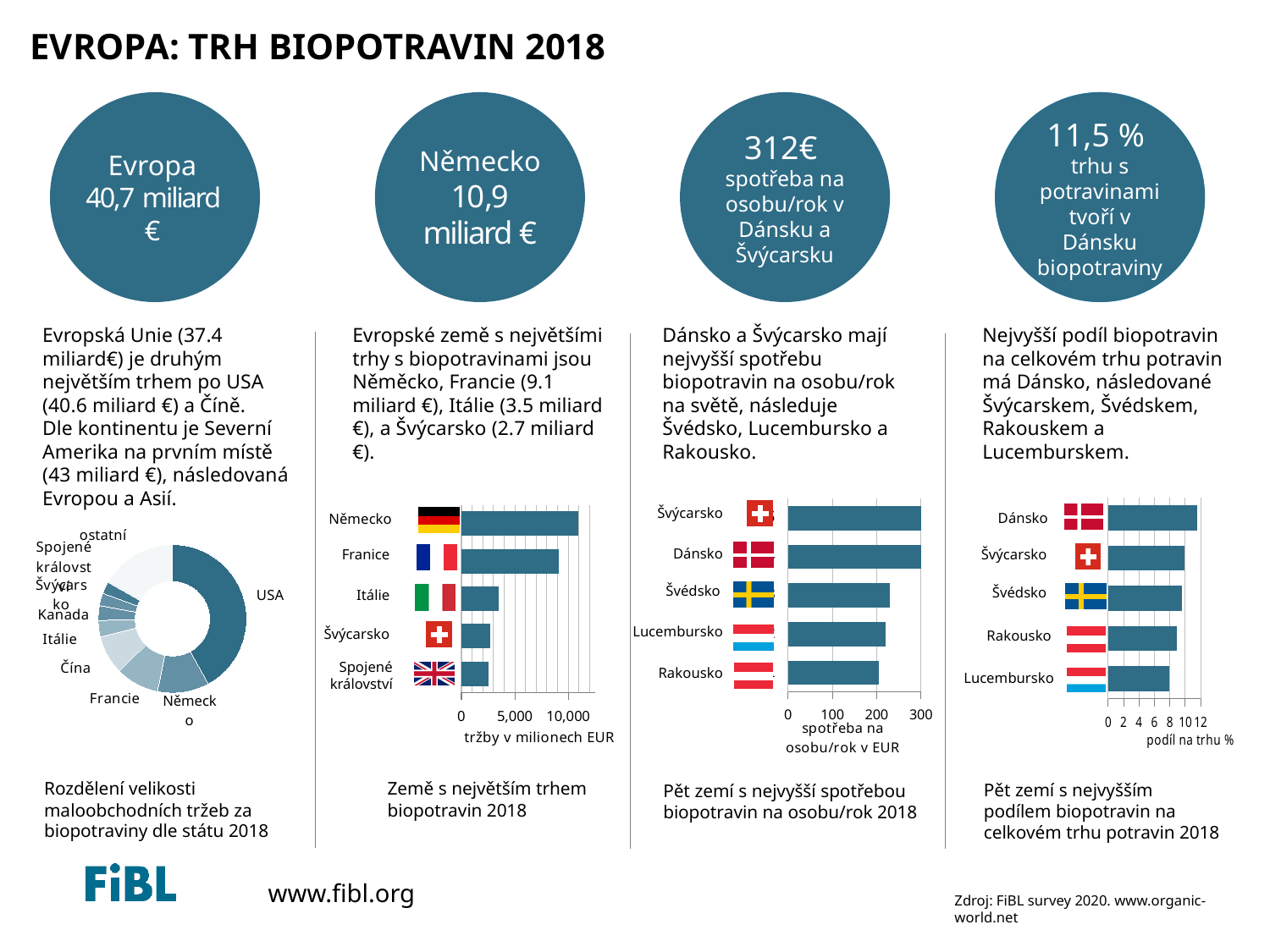
In the chart 'Země s největším trhem biopotravin 2018', which is larger, Německo or France? Německo What kind of chart is 'Země s největším trhem biopotravin 2018'? bar chart In the chart 'Země s největším trhem biopotravin 2018', which country has the highest value? Německo In the chart 'Pět zemí s nejvyšším podílem biopotravin na celkovém trhu potravin 2018', which country has the highest value? Dánsko In the chart 'Pět zemí s nejvyšší spotřebou biopotravin na osobu/rok 2018', how many countries are shown? 5 In the chart 'Země s největším trhem biopotravin 2018', is the value for Itálie greater or less than 5,000? less In the donut chart 'Rozdělení velikosti maloobchodních tržeb za biopotraviny dle státu 2018', which country has the largest slice? USA In the chart 'Země s největším trhem biopotravin 2018', how many countries are shown? 5 In the chart 'Pět zemí s nejvyšším podílem biopotravin na celkovém trhu potravin 2018', which country has the lowest value? Lucembursko In the chart 'Pět zemí s nejvyšším podílem biopotravin na celkovém trhu potravin 2018', is the value for Lucembursko greater or less than 10? less In the chart 'Pět zemí s nejvyšší spotřebou biopotravin na osobu/rok 2018', is the value for Švýcarsko greater or less than 300? greater What is the x-axis label of the chart 'Země s největším trhem biopotravin 2018'? tržby v milionech EUR